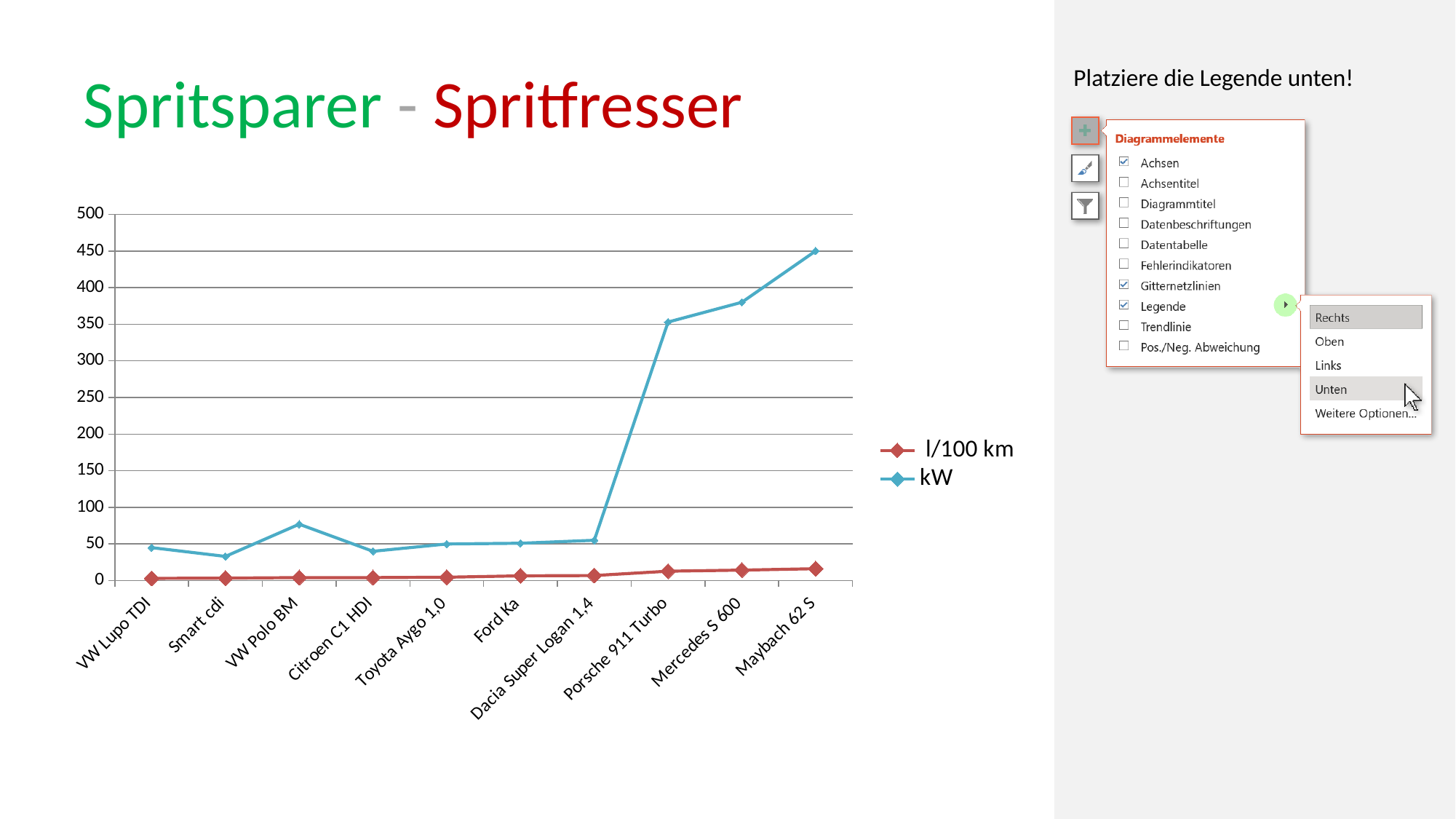
Is the kW value for VW Polo BM greater or less than 50? greater Is the kW value for Mercedes S 600 greater or less than 350? greater How many car models are plotted along the x axis? 10 Which car model has the highest kW value? Maybach 62 S Is the kW value for Porsche 911 Turbo greater or less than 300? greater How many series does the chart legend list? 2 Which series is drawn in blue in the chart? kW What is the title of the slide above the chart? Spritsparer - Spritfresser Which has the larger kW value, Ford Ka or Porsche 911 Turbo? Porsche 911 Turbo Does the kW series generally rise or fall from left to right along the x axis? rise What kind of chart is shown on the slide? line chart